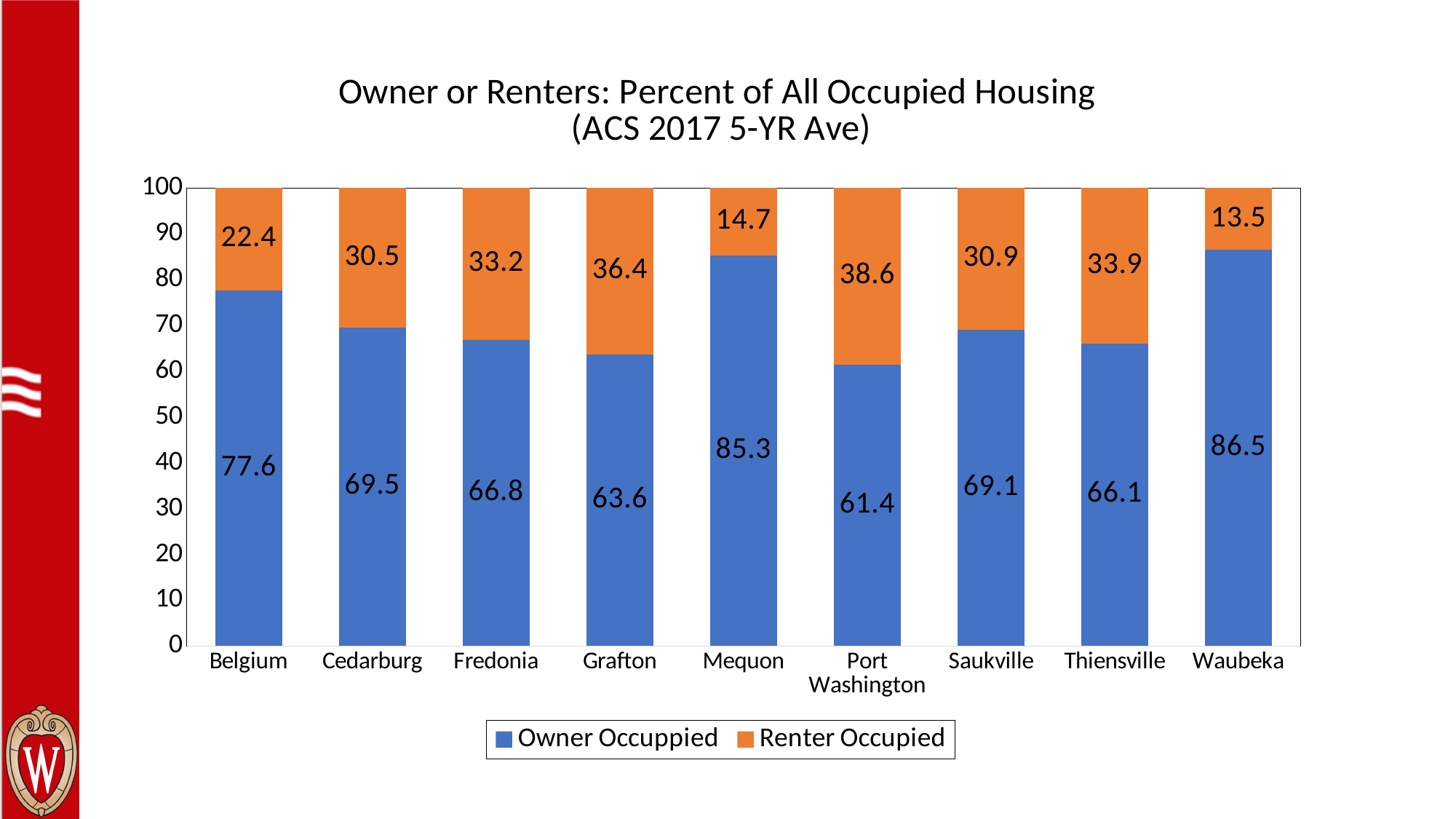
How many series does the legend list? 2 What is the Renter Occupied value for Port Washington? 38.6 Which community has the lowest Owner Occupied value? Port Washington What is the Owner Occupied value for Mequon? 85.3 What is the total of the stacked bar for Fredonia? 100 Which community has the lowest Renter Occupied value? Waubeka What is the difference between the Owner Occupied values for Belgium and Grafton? 14 Which is larger, the Renter Occupied value for Cedarburg or for Saukville? Saukville Which community has the highest Owner Occupied value? Waubeka What is the Owner Occupied value for Thiensville? 66.1 How many communities are shown on the x axis? 9 What kind of chart is shown on the slide? Stacked bar chart